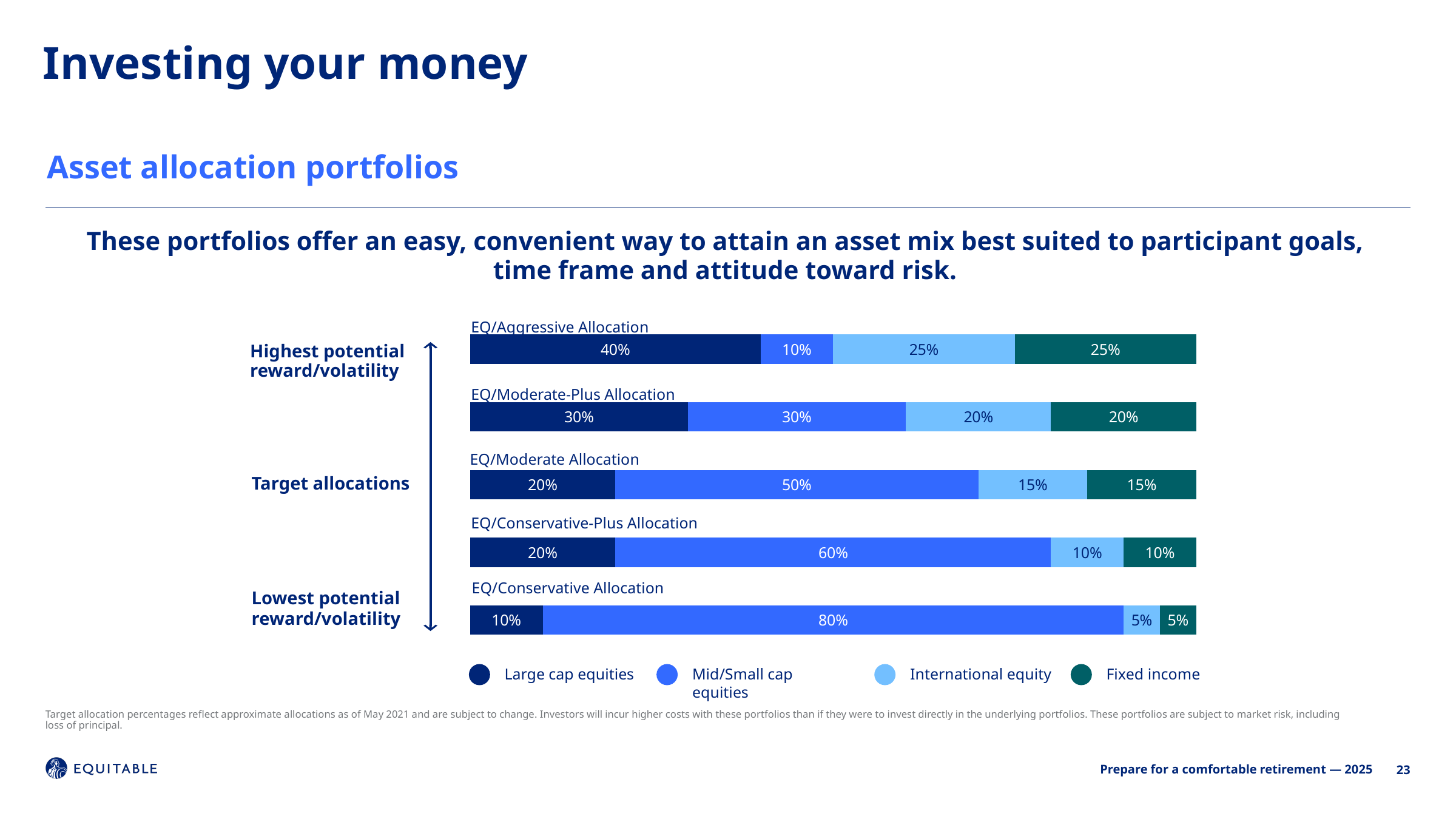
Which portfolio has the lowest Fixed income allocation? EQ/Conservative Allocation What is the total of the stacked bar for EQ/Moderate Allocation? 100% What is the Large cap equities allocation for EQ/Aggressive Allocation? 40% What is the Fixed income allocation for EQ/Moderate-Plus Allocation? 20% Which is larger: the International equity allocation for EQ/Moderate Allocation or for EQ/Moderate-Plus Allocation? EQ/Moderate-Plus Allocation How many series does the legend list? 4 Which portfolio has the highest Large cap equities allocation? EQ/Aggressive Allocation How many portfolios are shown in the chart? 5 What is the International equity allocation for EQ/Conservative-Plus Allocation? 10% What kind of chart is shown on the slide? Stacked bar chart What is the Mid/Small cap equities allocation for EQ/Conservative Allocation? 80% What is the difference between the Mid/Small cap equities allocation of EQ/Conservative Allocation and EQ/Aggressive Allocation? 70%